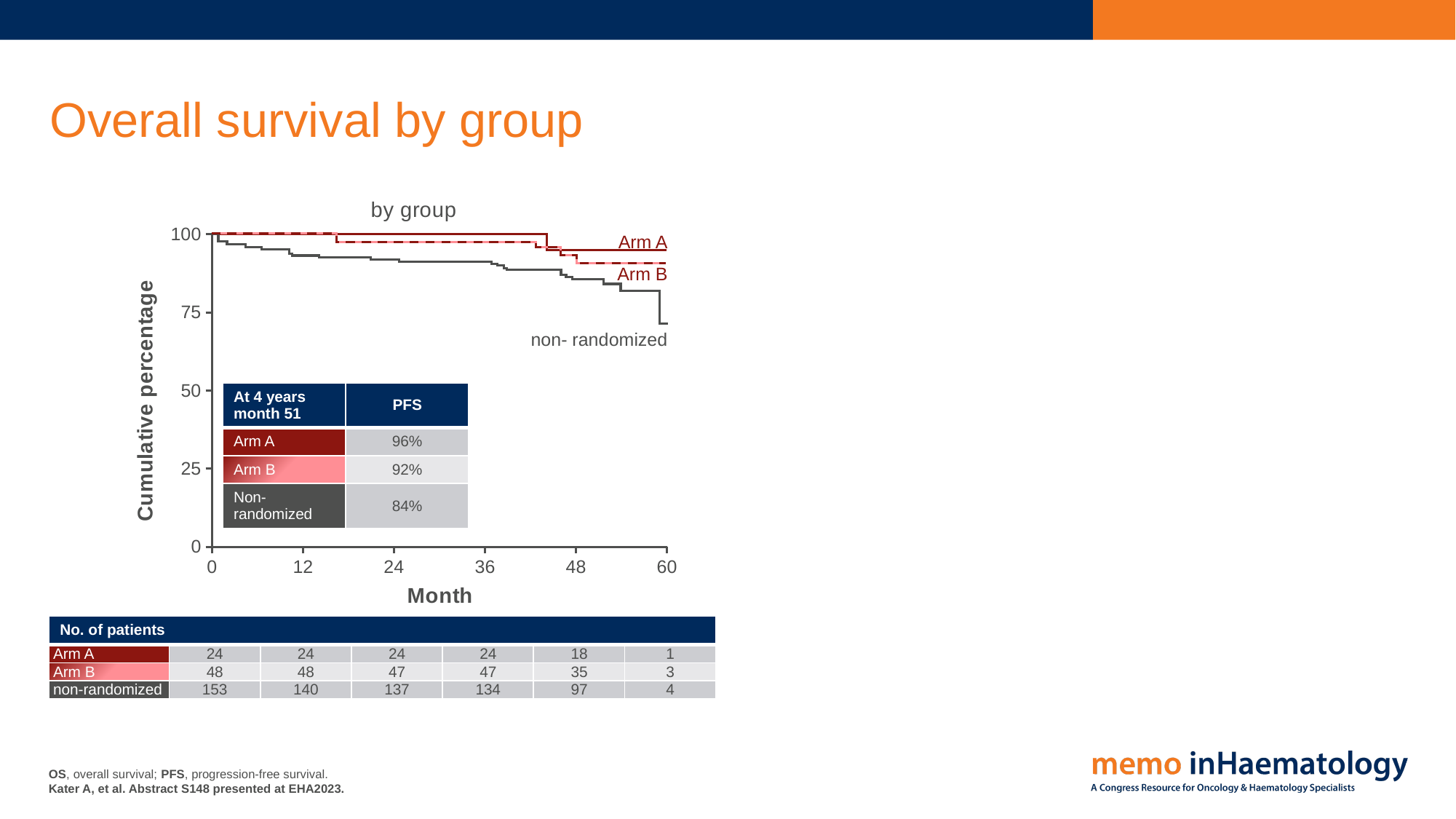
What is the label of the y-axis of the chart? Cumulative percentage According to the table in the chart, what is the PFS for Arm B at 4 years (month 51)? 92% According to the table in the chart, what is the PFS for Arm A at 4 years (month 51)? 96% How many groups are plotted in the chart? 3 Is the cumulative percentage for the non-randomized curve at month 48 greater or less than 75? greater According to the table in the chart, what is the PFS for the non-randomized group at 4 years (month 51)? 84% What kind of chart is shown on the slide? Line chart (Kaplan-Meier survival curve) Which has the higher PFS at 4 years, Arm B or the non-randomized group? Arm B What is the difference in PFS at 4 years between Arm A and Arm B? 4 percentage points Which group has the lowest PFS at 4 years (month 51)? Non-randomized Which group has the highest PFS at 4 years (month 51)? Arm A Do the survival curves rise or fall as the months increase? Fall